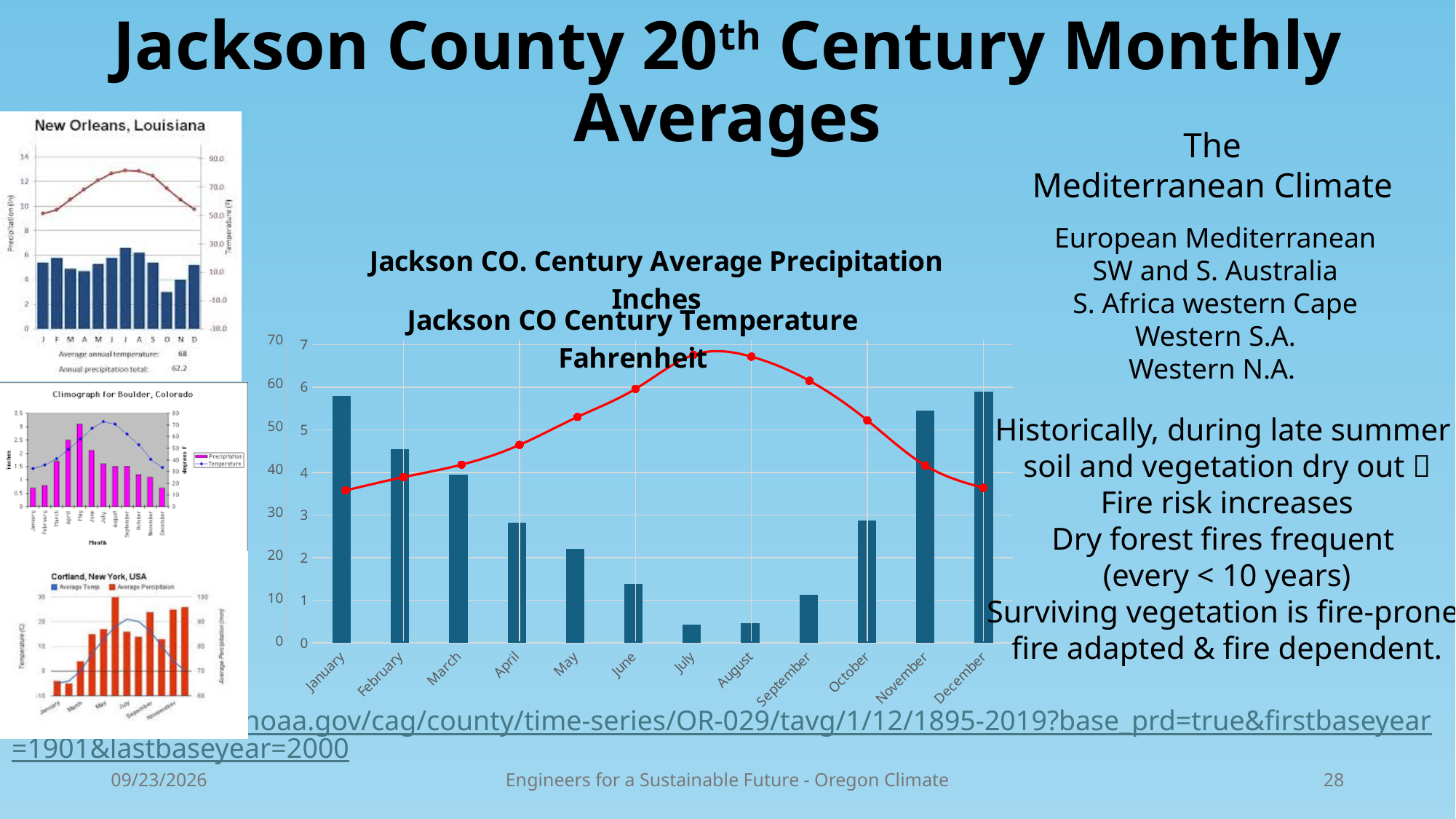
Does the temperature line rise or fall from January to July? Rises What kind of chart is used for the Jackson CO. Century Average Precipitation data? Bar chart What kind of chart is used for the Jackson CO Century Temperature data? Line chart What colour is the temperature line on the Jackson County chart? Red Is the precipitation value for July greater or less than 1 inch? less Is the temperature value for January greater or less than 40 degrees Fahrenheit? less Is the precipitation value for April greater or less than 4 inches? less Which month has higher average precipitation, January or July? January How many months are shown on the x axis of the Jackson County chart? 12 Which month has higher average precipitation, March or October? March